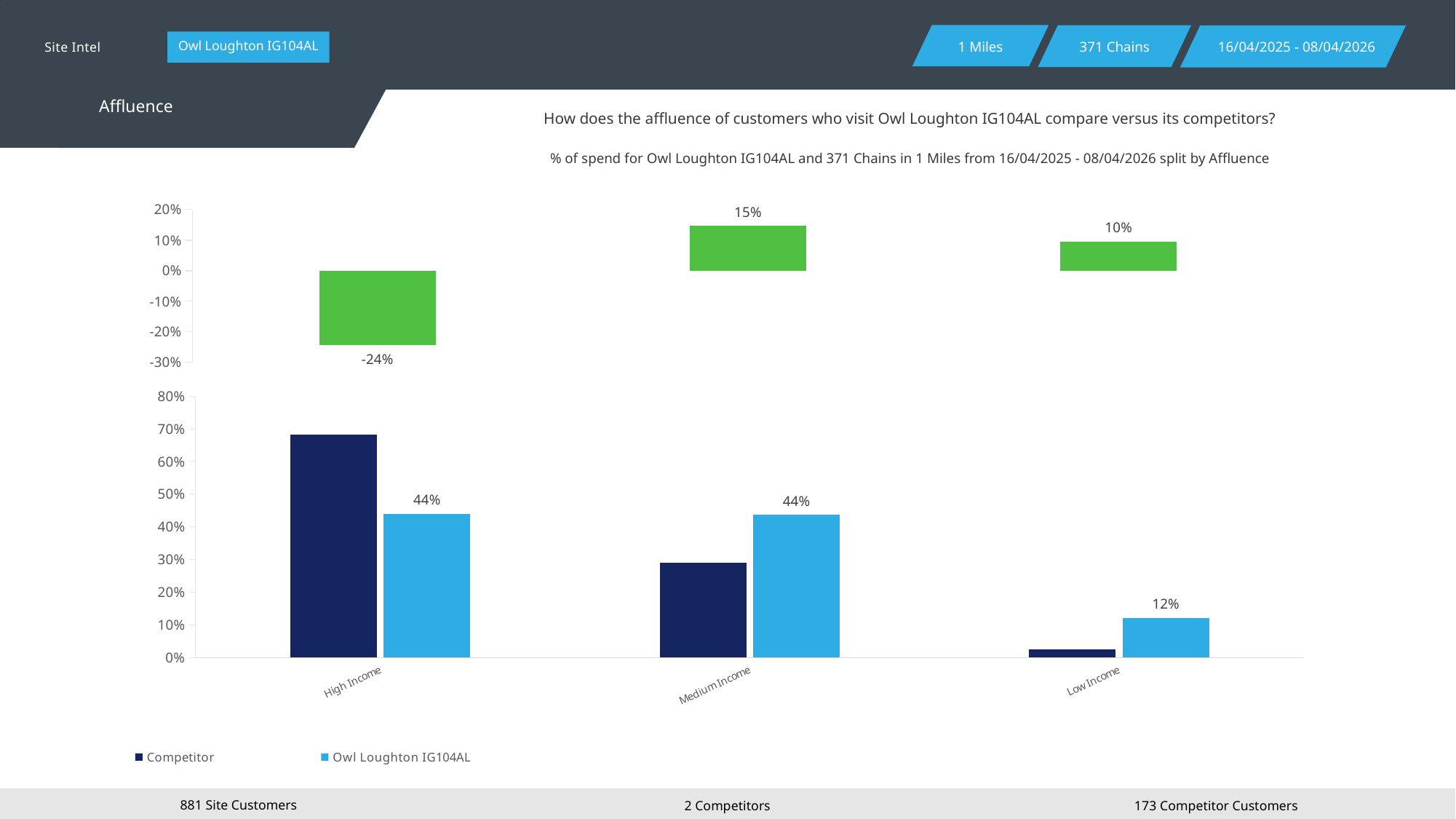
In the bottom chart, what is the difference between the Owl Loughton IG104AL values for High Income and Low Income? 32% In the bottom chart, what is the value for Owl Loughton IG104AL in the Medium Income category? 44% What kind of chart is the bottom chart? bar chart In the bottom chart, which is larger for High Income: Competitor or Owl Loughton IG104AL? Competitor In the top chart, which bar has the highest value? the middle bar (15%) In the bottom chart, is the Competitor value for High Income greater or less than 60%? greater In the bottom chart, is the Competitor value for Medium Income greater or less than 40%? less In the top chart, what is the value of the middle green bar? 15% In the bottom chart, what is the value for Owl Loughton IG104AL in the Low Income category? 12% In the bottom chart, what is the value for Owl Loughton IG104AL in the High Income category? 44% In the top chart, what is the value of the leftmost green bar? -24% How many series does the legend of the bottom chart list? 2